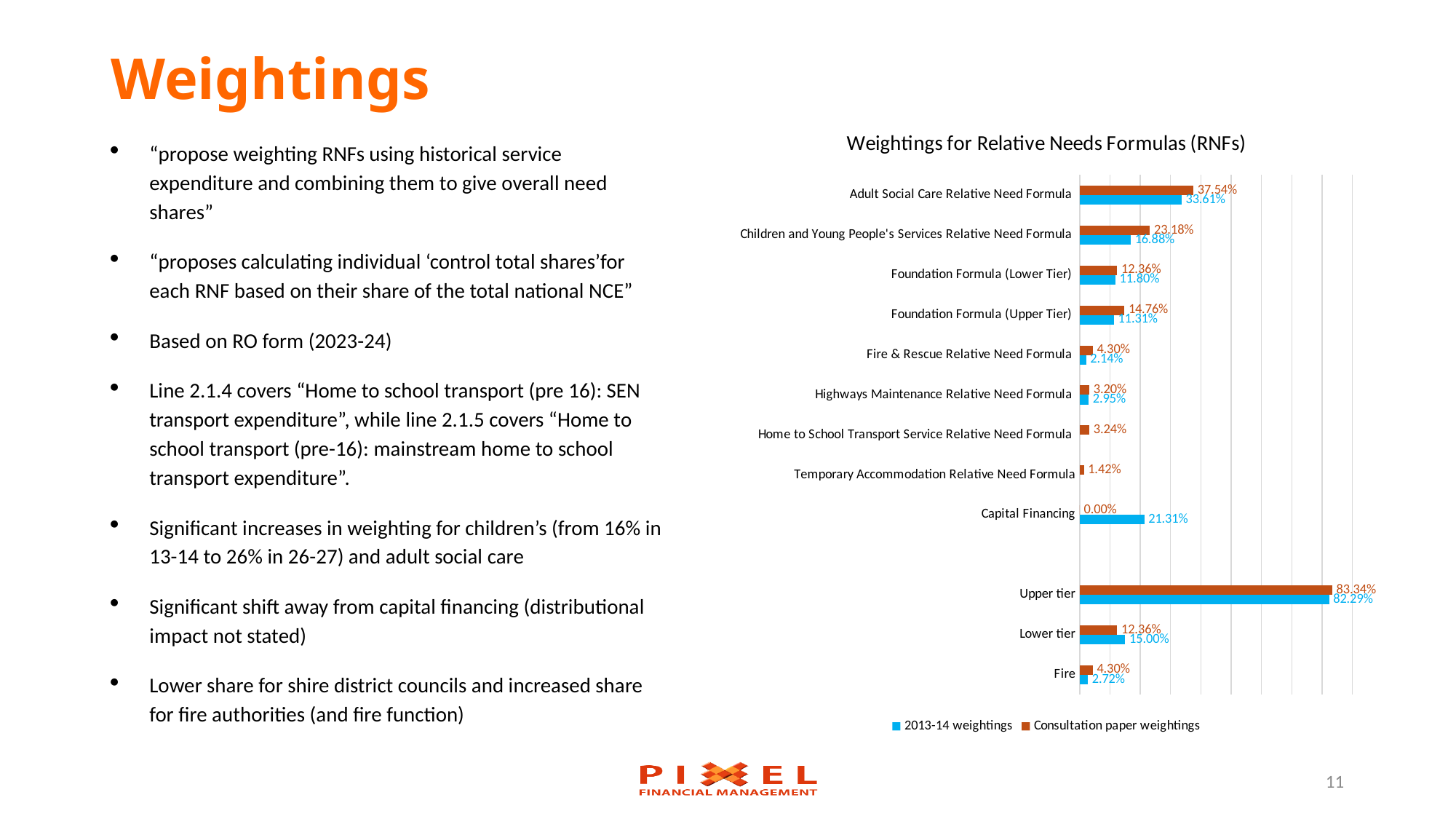
What type of chart is shown on the slide? Bar chart How many categories are shown on the chart? 12 What is the Consultation paper weighting for the Adult Social Care Relative Need Formula? 37.54% What is the Consultation paper weighting for the Temporary Accommodation Relative Need Formula? 1.42% What is the 2013-14 weighting for the Children and Young People's Services Relative Need Formula? 16.88% Which category has the lowest Consultation paper weighting? Capital Financing What is the difference between the Consultation paper weighting and the 2013-14 weighting for the Children and Young People's Services Relative Need Formula? 6.30% How many series does the legend list? 2 Which category has the highest Consultation paper weighting? Upper tier For Lower tier, which is larger: the 2013-14 weighting or the Consultation paper weighting? 2013-14 weighting For the Fire & Rescue Relative Need Formula, which is larger: the 2013-14 weighting or the Consultation paper weighting? Consultation paper weighting What is the 2013-14 weighting for Capital Financing? 21.31%